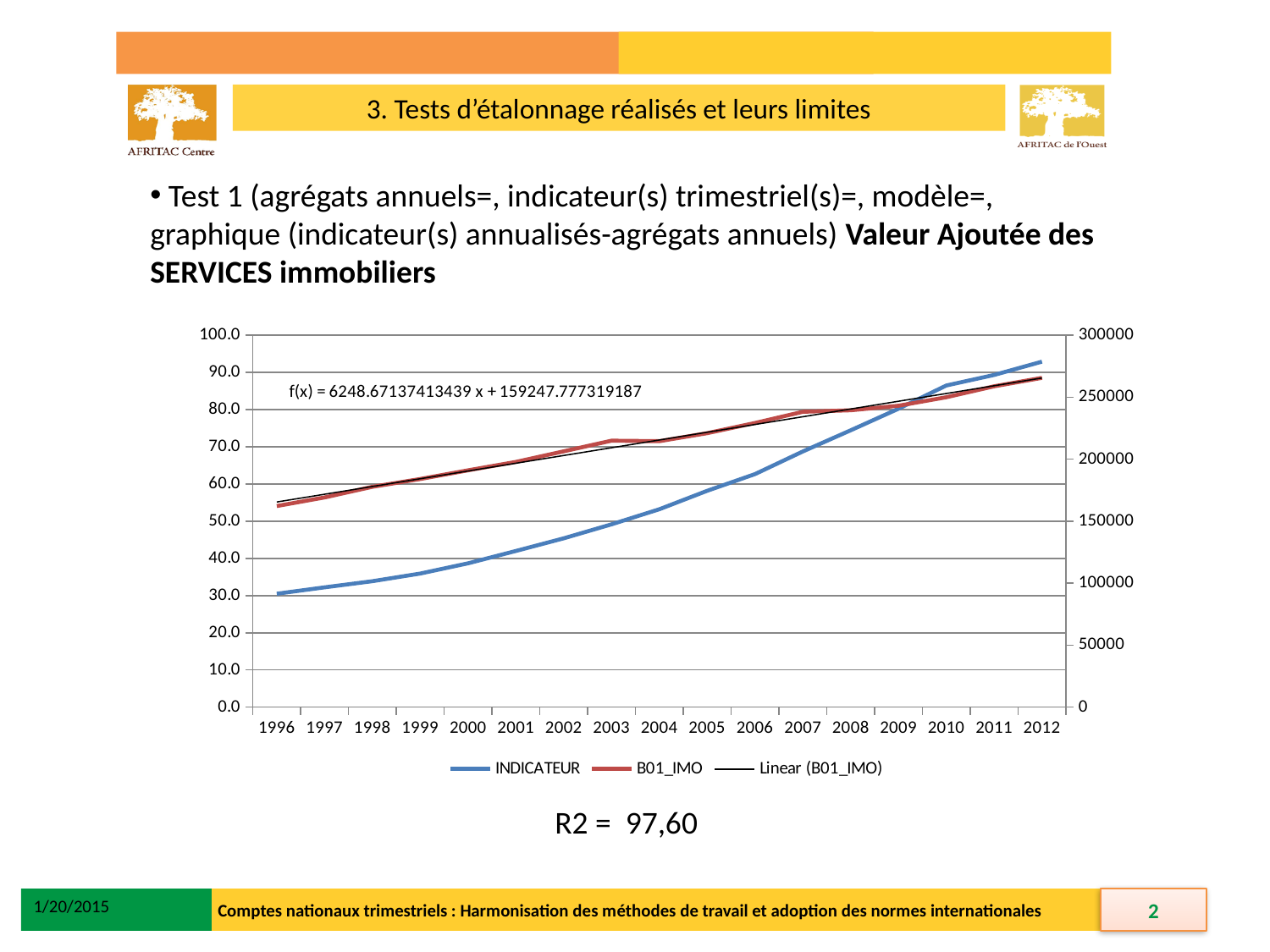
Read against the left axis, is the INDICATEUR value in 2006 greater or less than 70.0? less Does the B01_IMO line generally rise or fall from 1996 to 2012? rise How many years are shown along the x axis of the chart? 17 Read against the left axis, is the INDICATEUR value in 1996 greater or less than 40.0? less How many entries does the chart legend list? 3 In 1996, which line is plotted higher on the chart, INDICATEUR or B01_IMO? B01_IMO What is the first year shown on the x axis of the chart? 1996 What kind of chart is shown on the slide? line chart In 2012, which line is plotted higher on the chart, INDICATEUR or B01_IMO? INDICATEUR Read against the left axis, is the INDICATEUR value in 2012 greater or less than 90.0? greater What is the last year shown on the x axis of the chart? 2012 Does the INDICATEUR line rise or fall from 1996 to 2012? rise